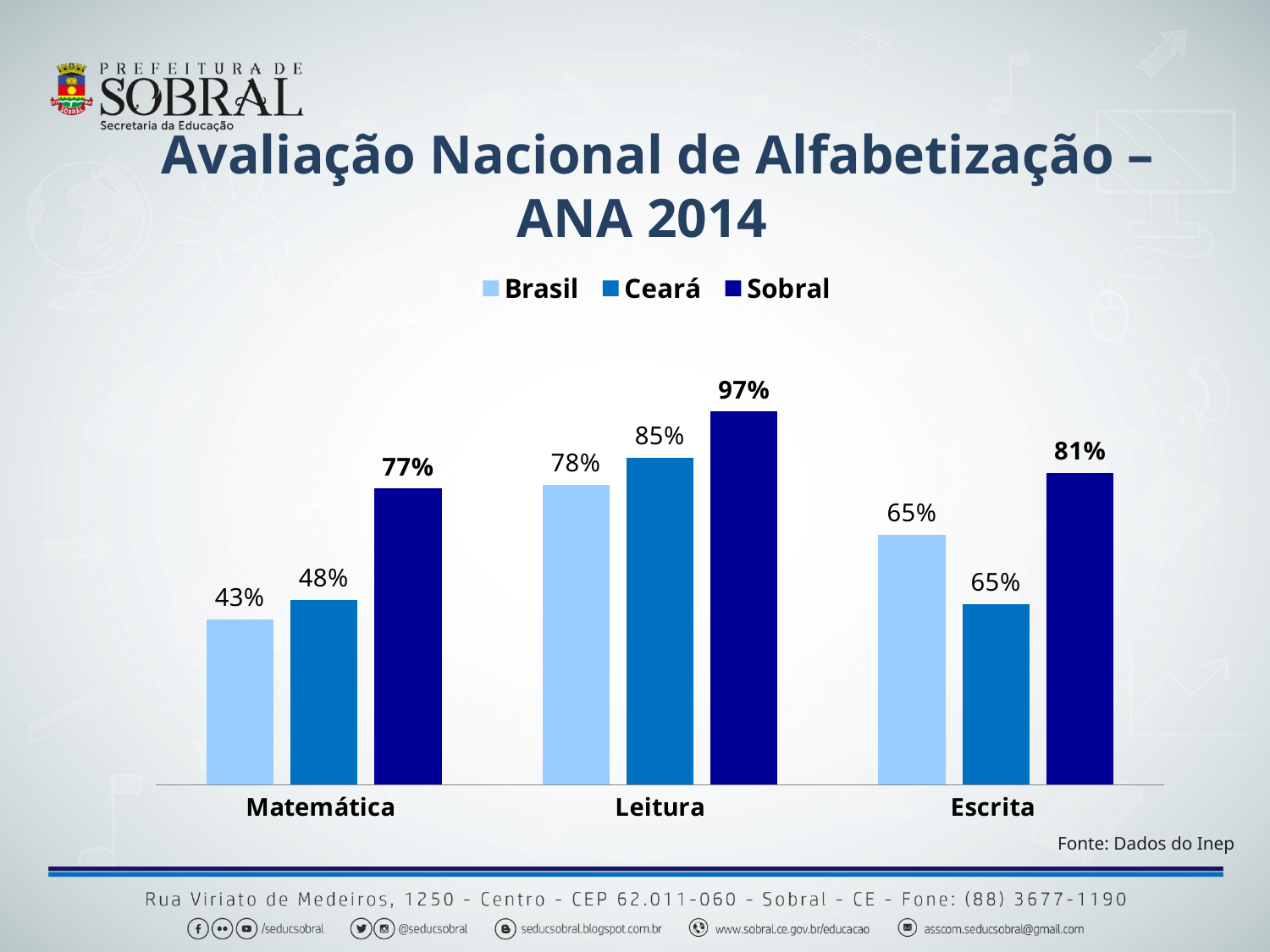
What is the value for Sobral in Matemática? 77% How many series does the legend list? 3 Which is larger in Escrita, Brasil or Sobral? Sobral How many categories are shown on the x axis? 3 What is the difference between Sobral and Brasil in Matemática? 34% What is the value for Brasil in Leitura? 78% What kind of chart is shown on the slide? Bar chart Which category has the highest value for Sobral? Leitura What is the source cited below the chart? Fonte: Dados do Inep Which category has the lowest value for Brasil? Matemática What is the value for Ceará in Escrita? 65% What is the difference between Sobral and Ceará in Leitura? 12%